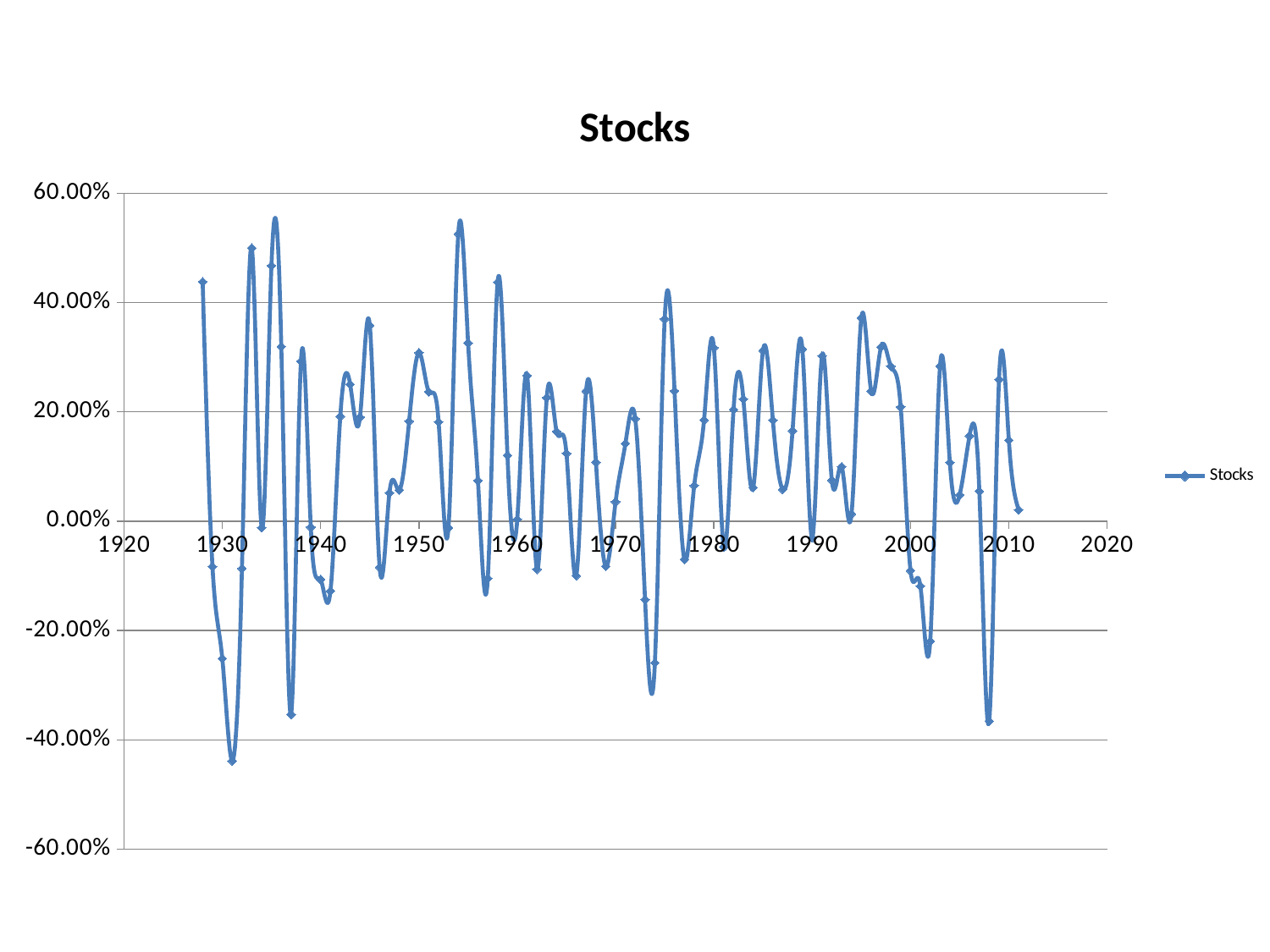
Is the value for 1974 greater or less than -20.00%? less Is the value for 1928 greater or less than 40.00%? greater What is the title of the chart? Stocks Is the value for 1937 greater or less than -20.00%? less What kind of chart is shown on the slide? line chart What is the name of the series shown in the legend? Stocks How many series does the legend list? 1